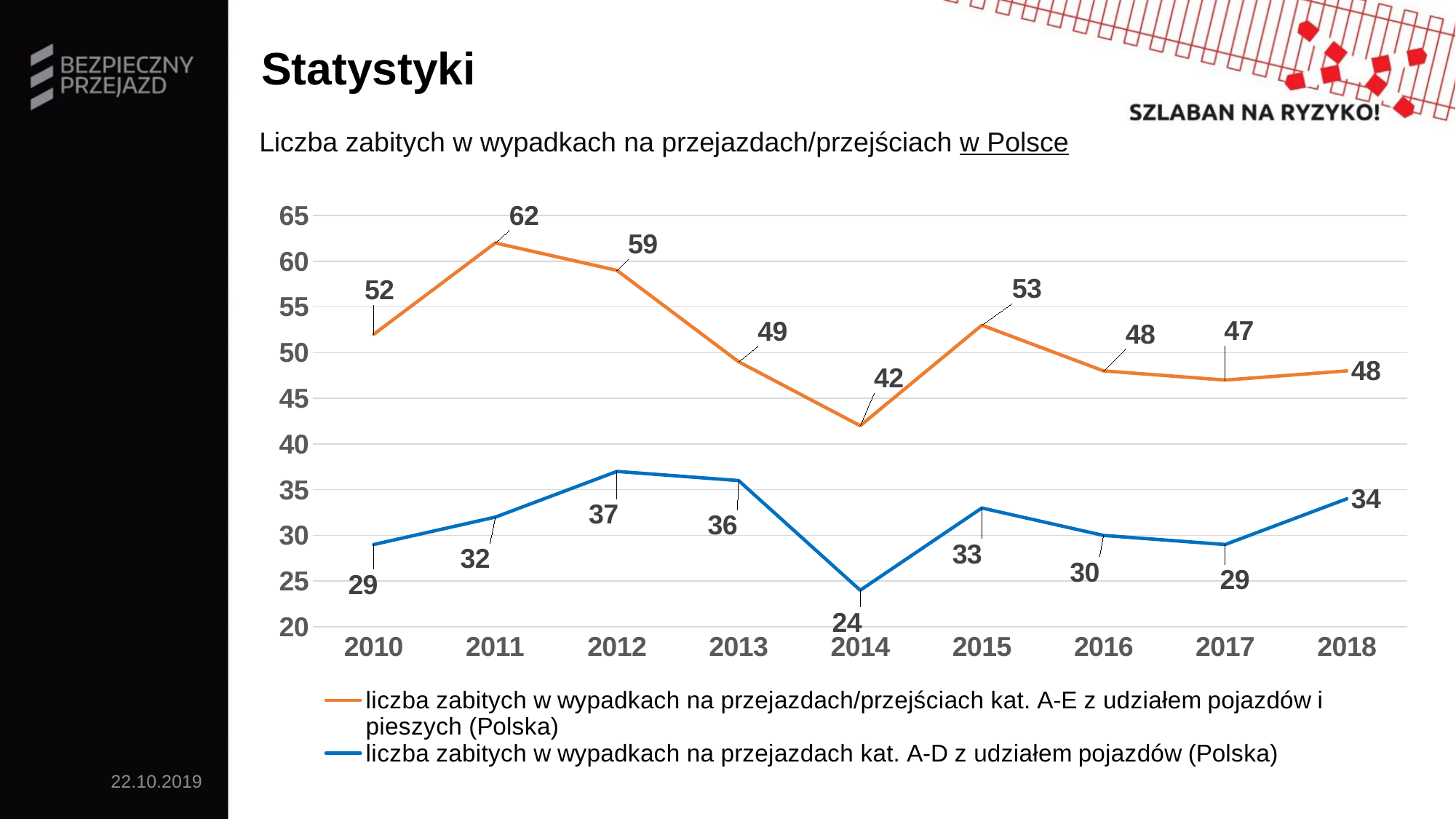
What is the difference between the orange series and the blue series in 2010? 23 Which is larger: the blue series value in 2012 or in 2018? 2012 What kind of chart is shown on the slide? line chart What colour is the line for the kat. A-D series? blue What is the value of the blue series (kat. A-D) in 2014? 24 How many series does the legend list? 2 In which year does the blue series (kat. A-D) reach its lowest value? 2014 How many years are shown on the x axis? 9 What is the value of the orange series (kat. A-E) in 2018? 48 What is the value of the orange series (kat. A-E) in 2011? 62 Does the orange series rise or fall from 2011 to 2014? fall In which year does the orange series (kat. A-E) reach its highest value? 2011